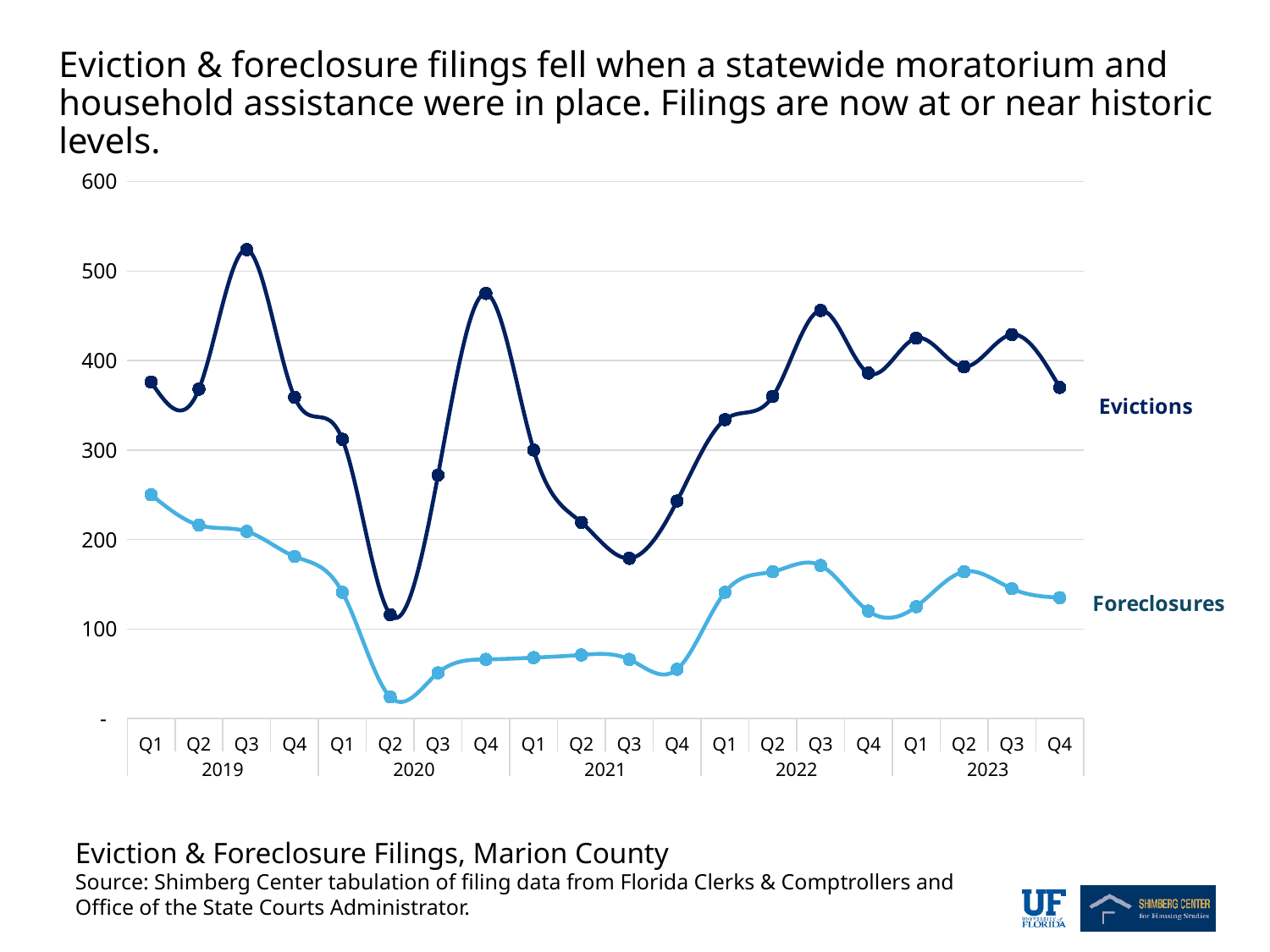
Which is larger: the Evictions value in Q3 2019 or in Q4 2020? Q3 2019 What kind of chart is shown on the slide? Line chart In which quarter does the Evictions line reach its highest value? Q3 2019 Is the Foreclosures value for Q2 2020 greater or less than 100? less Is the Evictions value for Q3 2019 greater or less than 500? greater Is the Evictions value for Q4 2023 greater or less than 400? less How many series are plotted on the chart? 2 In which quarter does the Evictions line reach its lowest value? Q2 2020 In which quarter does the Foreclosures line reach its lowest value? Q2 2020 In which quarter does the Foreclosures line reach its highest value? Q1 2019 How many quarterly data points does each line have? 20 Do the Evictions values rise or fall from Q1 2020 to Q2 2020? fall